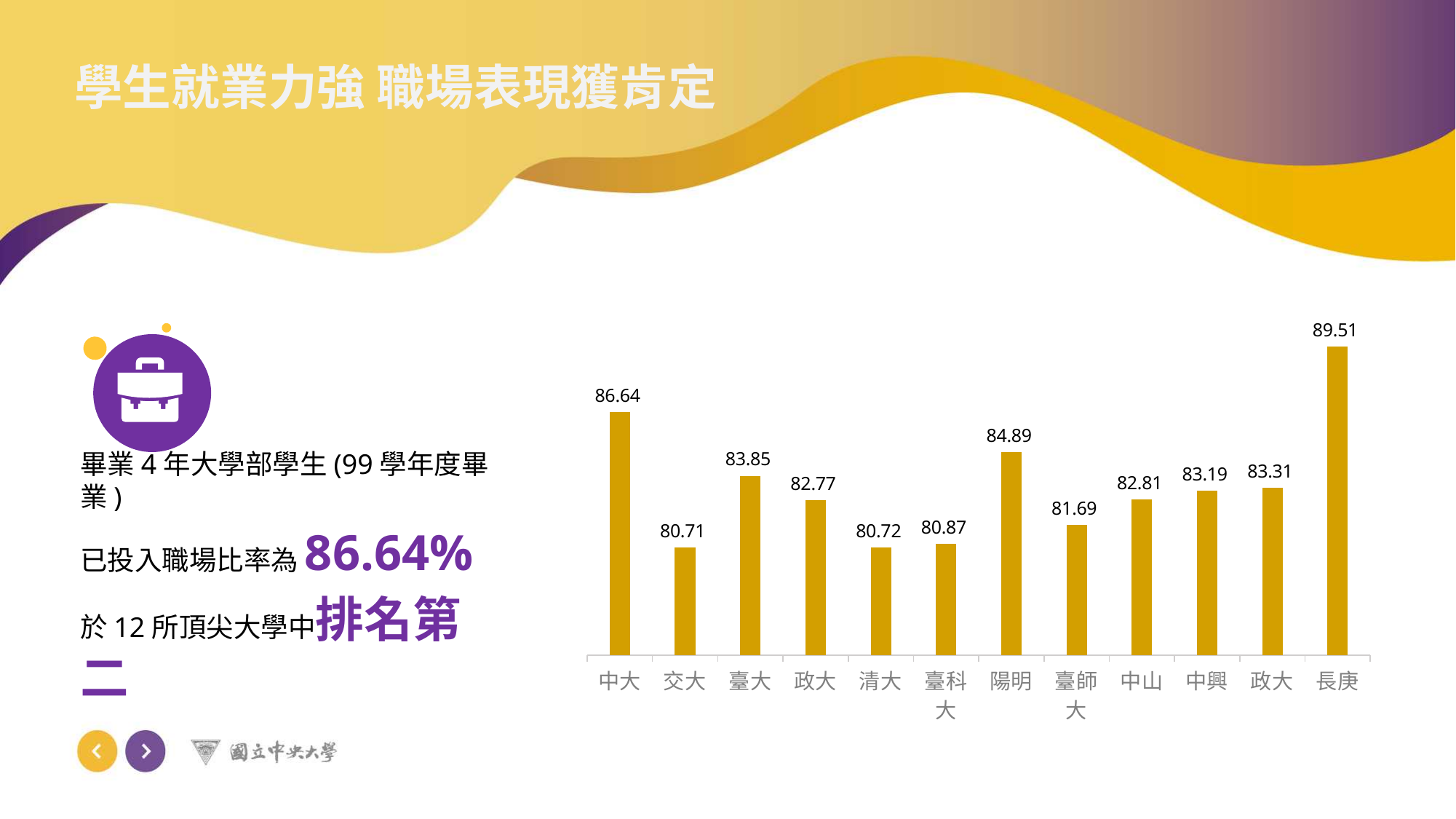
What is the value for 陽明? 84.89 Which university has the highest value in the chart? 長庚 What is the difference between the values for 中大 and 交大? 5.93 What is the difference between the values for 長庚 and 中大? 2.87 How many universities are shown in the chart? 12 What is the value for 中大? 86.64 What is the value for 臺師大? 81.69 What is the value for 長庚? 89.51 Which has a larger value, 陽明 or 臺大? 陽明 Which has a larger value, 中興 or 中山? 中興 What kind of chart is shown on the slide? bar chart Which university has the lowest value in the chart? 交大